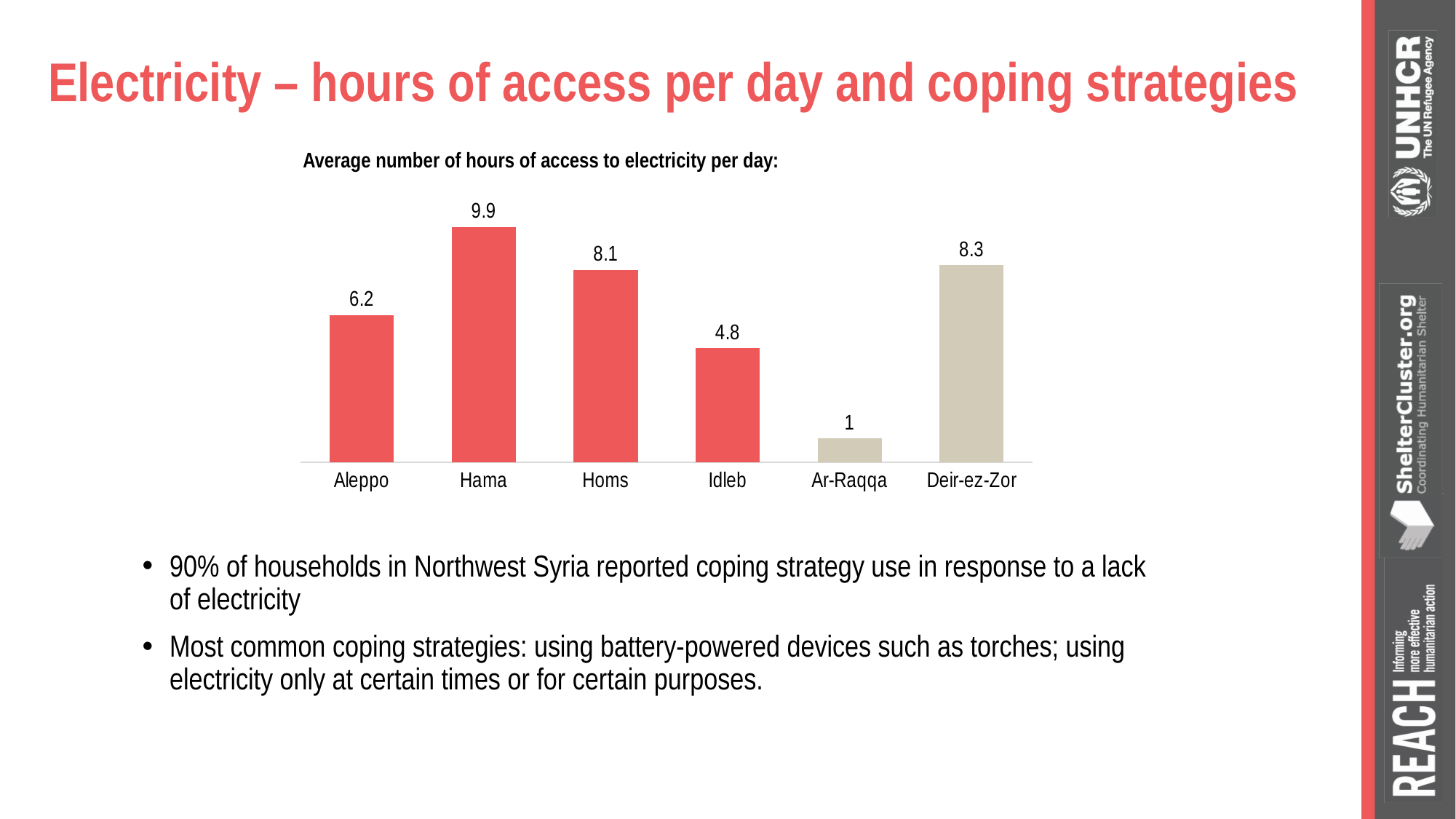
What is the title of the chart on the slide? Average number of hours of access to electricity per day: What is the average number of hours of access to electricity per day in Aleppo? 6.2 How many governorates are shown in the chart? 6 What is the average number of hours of access to electricity per day in Ar-Raqqa? 1 Which governorate has the lowest average number of hours of access to electricity per day? Ar-Raqqa What is the difference in average hours of electricity access per day between Deir-ez-Zor and Homs? 0.2 What is the difference in average hours of electricity access per day between Hama and Idleb? 5.1 Which has more average hours of electricity access per day, Aleppo or Idleb? Aleppo What is the average number of hours of access to electricity per day in Hama? 9.9 What is the average number of hours of access to electricity per day in Deir-ez-Zor? 8.3 What kind of chart is used to show the average hours of access to electricity per day? Bar chart Which governorate has the highest average number of hours of access to electricity per day? Hama